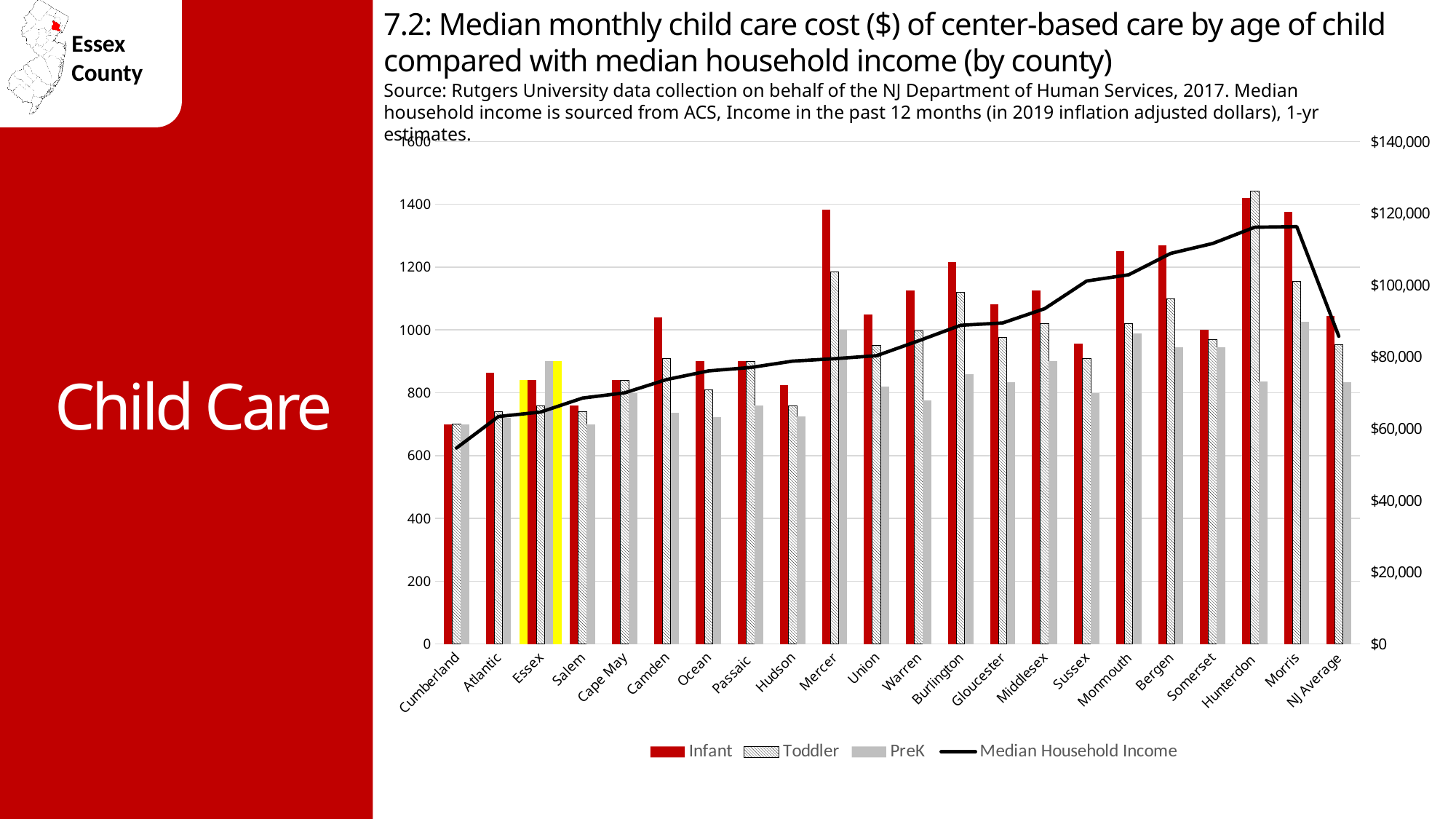
Which is larger, the Infant cost for Mercer or the Infant cost for Union? Mercer Is the Median Household Income for Morris greater or less than $100,000? greater How many categories are shown along the x axis of the chart? 22 Does the Median Household Income line generally rise or fall from Cumberland to Morris? rise Which county's bars are highlighted in yellow on the chart? Essex Which county has the highest Toddler child care cost? Hunterdon Which county has the lowest Infant child care cost? Cumberland What kind of chart is used to show the child care costs? bar chart (with a line for median household income) Which county has the highest Infant child care cost? Hunterdon Is the Infant cost for Cumberland greater or less than 800? less How many series does the chart legend list? 4 Is the Infant cost for Mercer greater or less than 1200? greater